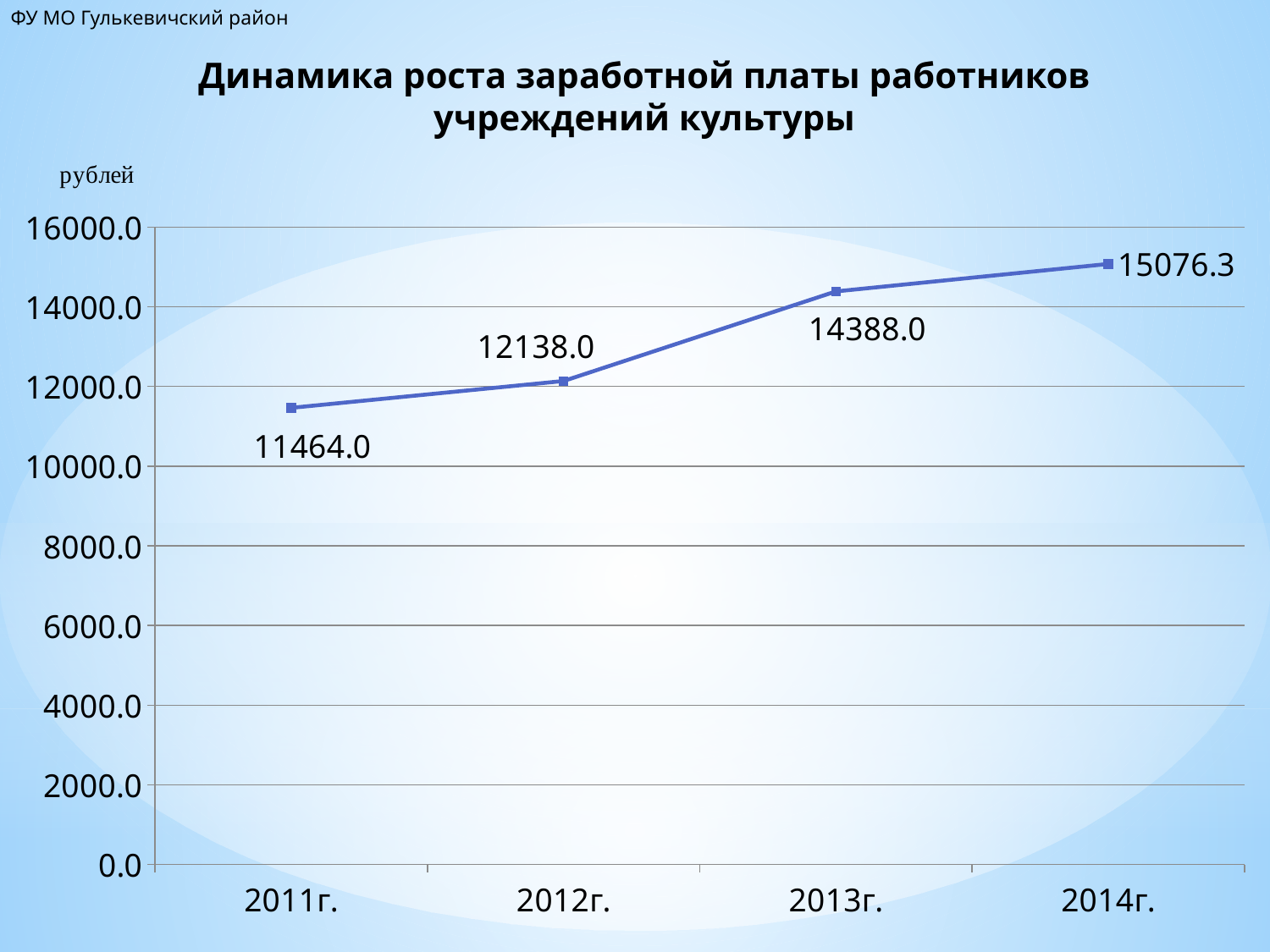
Is the value for 2013г. greater or less than 14000.0? greater Which year has the lowest value? 2011г. How many years are plotted on the chart? 4 What kind of chart is shown on the slide? line chart What is the value for 2012г.? 12138.0 Which year has the highest value? 2014г. What is the value for 2013г.? 14388.0 Which is larger, the value for 2012г. or the value for 2013г.? 2013г. What is the value for 2011г.? 11464.0 What is the difference between the values for 2013г. and 2012г.? 2250.0 What is the difference between the values for 2014г. and 2011г.? 3612.3 What is the value for 2014г.? 15076.3